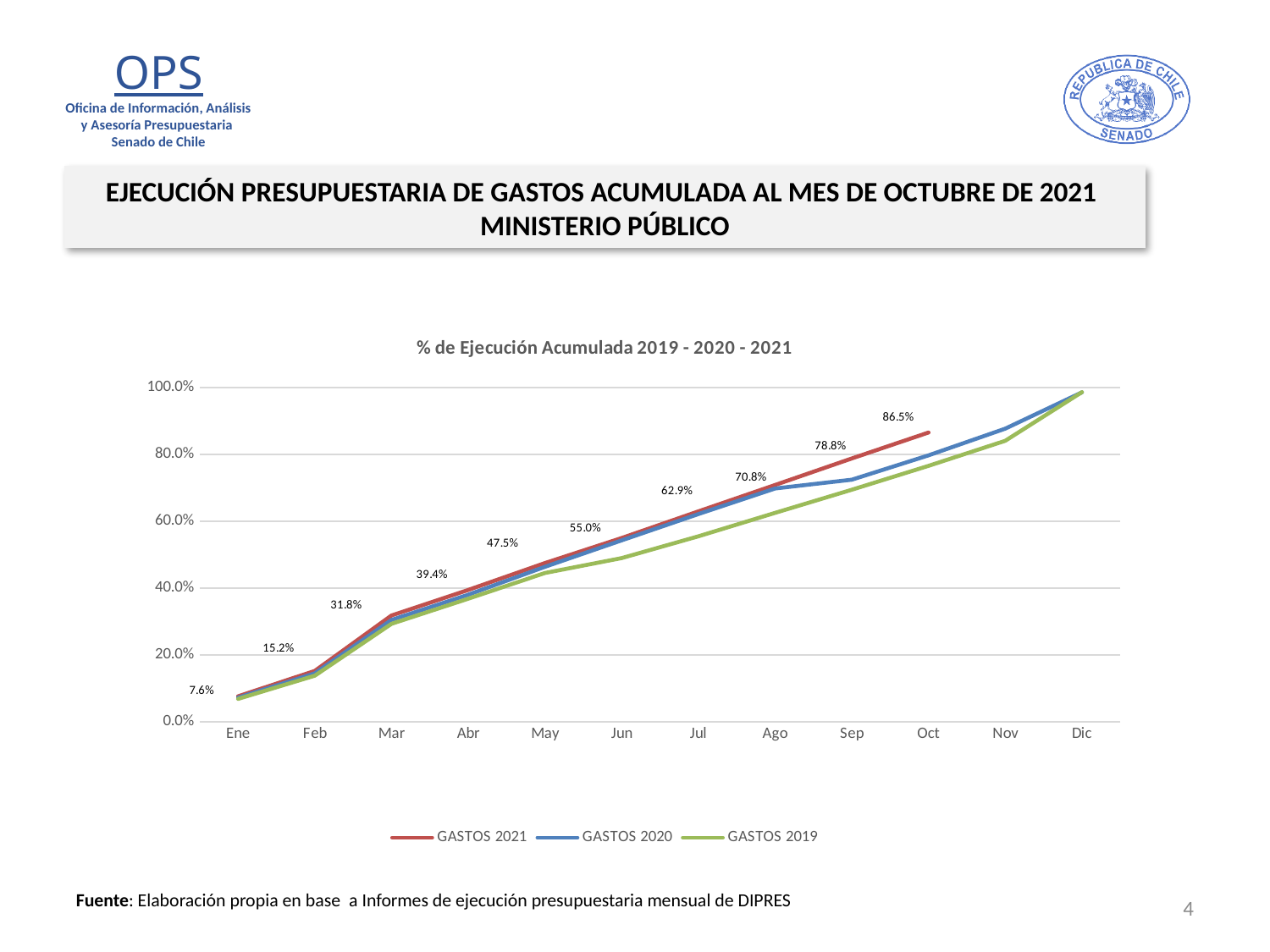
What is the value for GASTOS 2021 in Ene? 7.6% What is the value for GASTOS 2021 in Mar? 31.8% Does the GASTOS 2021 line rise or fall from Ene to Oct? rise What type of chart is shown on the slide? line chart What is the difference between the GASTOS 2021 values for Oct and Sep? 7.7% Which series is shown in red in the chart? GASTOS 2021 What is the title of the chart? % de Ejecución Acumulada 2019 - 2020 - 2021 What is the value for GASTOS 2021 in Jun? 55.0% How many series does the chart legend list? 3 How many months are shown on the x axis of the chart? 12 Is the value for GASTOS 2019 in Sep greater or less than 80.0%? less What is the value for GASTOS 2021 in Oct? 86.5%